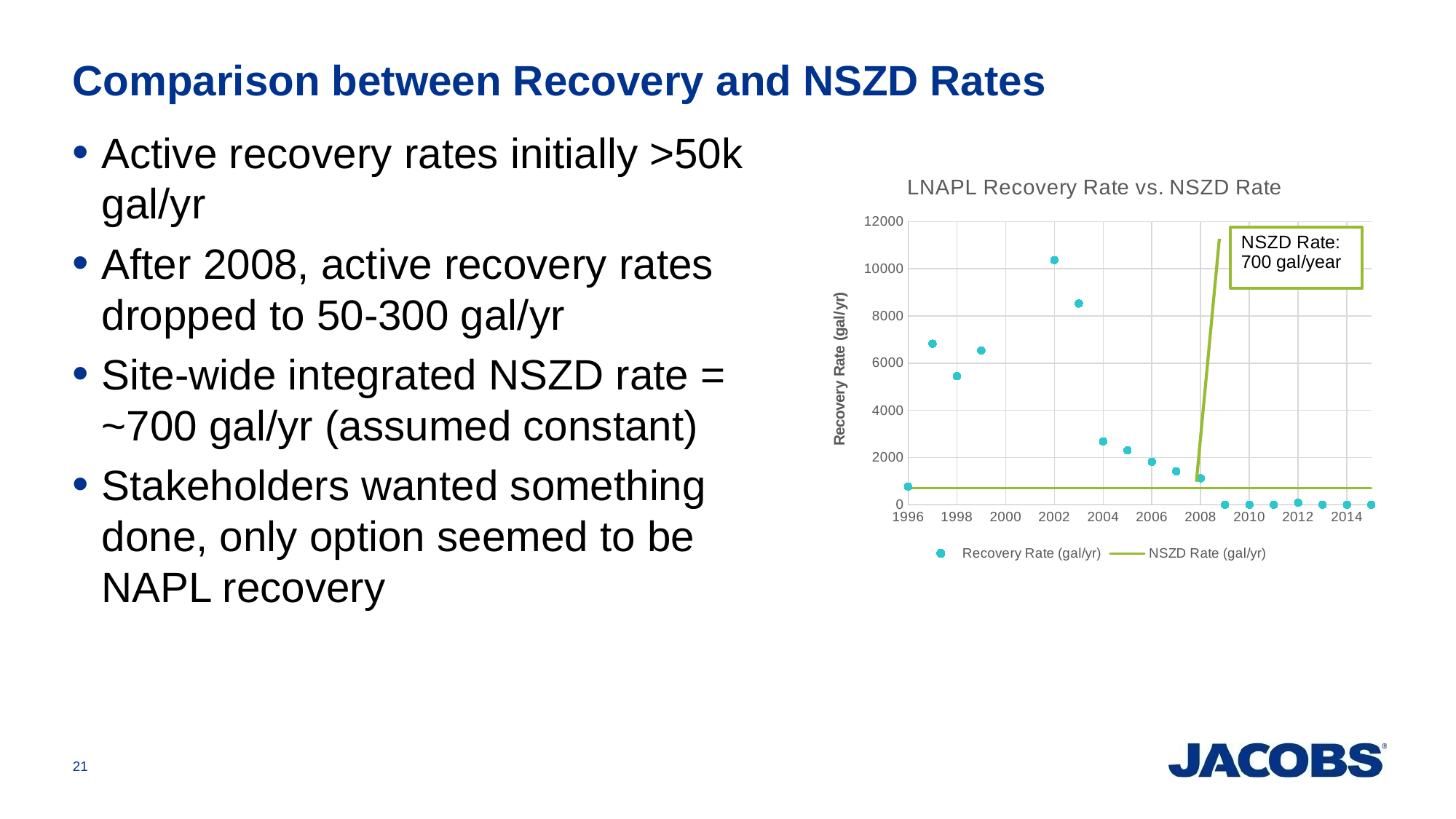
Is the recovery rate for 2003 greater or less than 8000? greater Is the recovery rate for 2002 greater or less than 10000? greater What NSZD rate is stated in the annotation box on the chart? 700 gal/year Which year has the larger recovery rate, 1998 or 1999? 1999 What is the title of the chart? LNAPL Recovery Rate vs. NSZD Rate How many series does the chart legend list? 2 Is the recovery rate for 1997 greater or less than 6000? greater What is the label of the vertical axis? Recovery Rate (gal/yr) What kind of chart is shown on the slide? Scatter chart Do the recovery rates rise or fall from 2002 to 2008? Fall